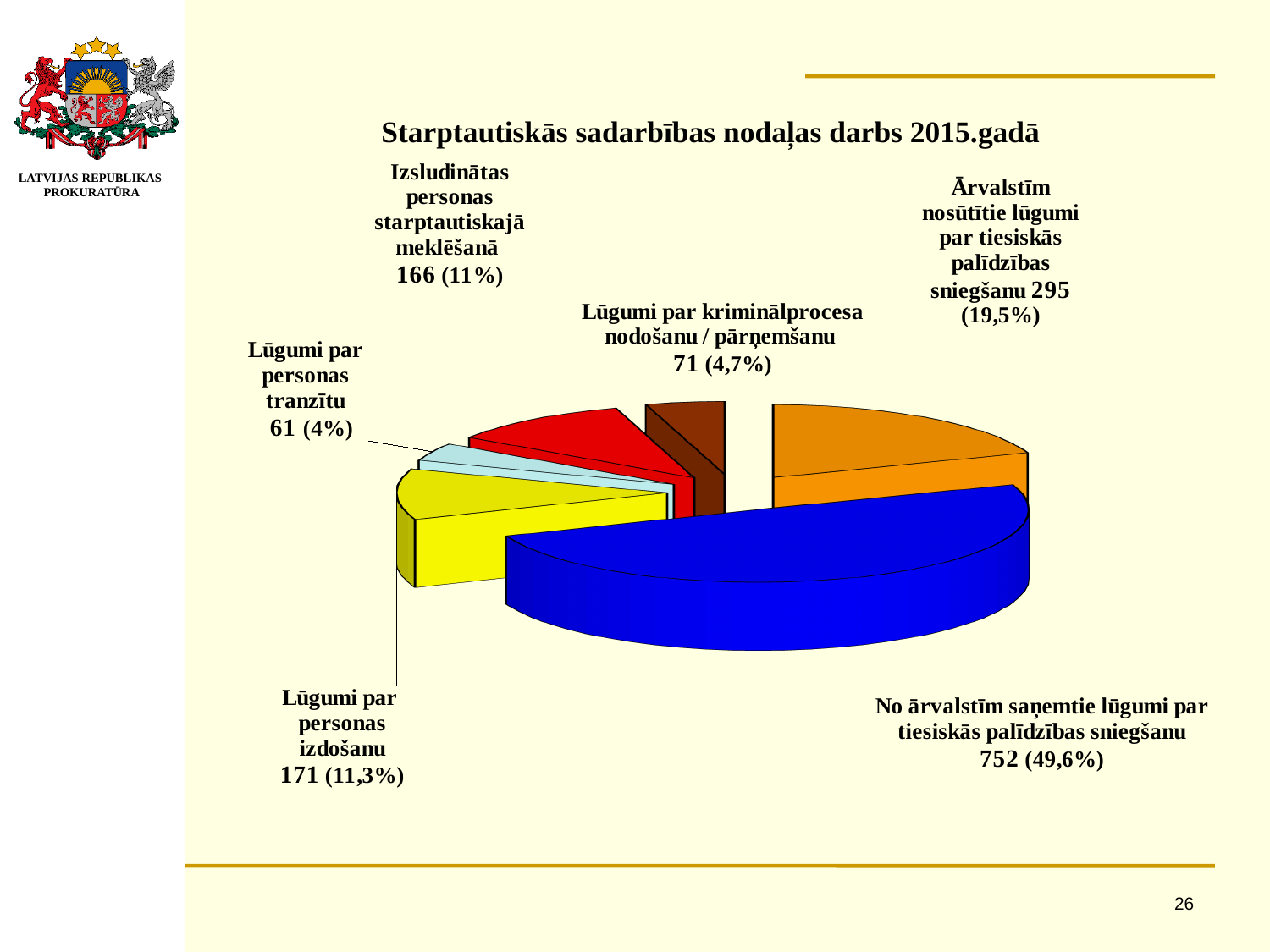
What is the value for "No ārvalstīm saņemtie lūgumi par tiesiskās palīdzības sniegšanu"? 752 How many slices does the pie chart have? 6 What type of chart is shown on the slide? Pie chart What share of the pie does "Ārvalstīm nosūtītie lūgumi par tiesiskās palīdzības sniegšanu" represent? 19,5% What is the value for "Lūgumi par personas tranzītu"? 61 Which is larger: "Ārvalstīm nosūtītie lūgumi par tiesiskās palīdzības sniegšanu" or "Lūgumi par personas izdošanu"? Ārvalstīm nosūtītie lūgumi par tiesiskās palīdzības sniegšanu What is the difference between the values for "Lūgumi par personas izdošanu" and "Izsludinātas personas starptautiskajā meklēšanā"? 5 Which category has the smallest slice? Lūgumi par personas tranzītu What is the title of the chart? Starptautiskās sadarbības nodaļas darbs 2015.gadā What colour is the slice for "No ārvalstīm saņemtie lūgumi par tiesiskās palīdzības sniegšanu"? Blue What share of the pie does "Lūgumi par kriminālprocesa nodošanu / pārņemšanu" represent? 4,7% Which category has the largest slice? No ārvalstīm saņemtie lūgumi par tiesiskās palīdzības sniegšanu